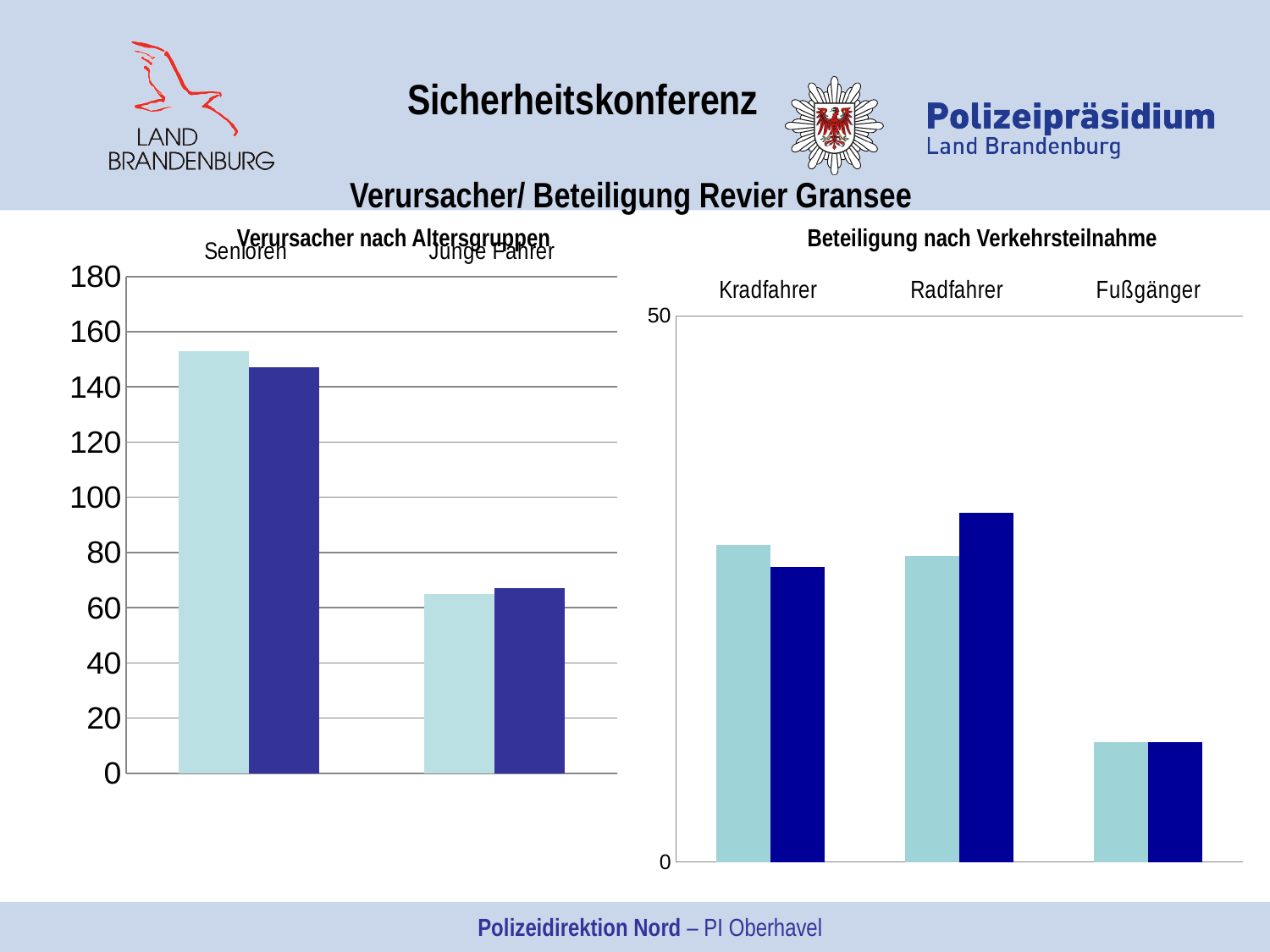
In the 'Beteiligung nach Verkehrsteilnahme' chart, which category has the lowest bars? Fußgänger In the 'Beteiligung nach Verkehrsteilnahme' chart, which category has the tallest bar? Radfahrer In the 'Verursacher nach Altersgruppen' chart, is the value of the light blue bar for Senioren greater or less than 140? greater In the 'Beteiligung nach Verkehrsteilnahme' chart, which is larger: the dark blue bar for Radfahrer or the dark blue bar for Fußgänger? Radfahrer What is the title of the chart on the right side of the slide? Beteiligung nach Verkehrsteilnahme In the 'Verursacher nach Altersgruppen' chart, do the values rise or fall from Senioren to Junge Fahrer? fall What kind of chart is the 'Verursacher nach Altersgruppen' chart on the left? bar chart In the 'Beteiligung nach Verkehrsteilnahme' chart, is the value of the dark blue bar for Kradfahrer greater or less than 50? less How many categories are shown on the x axis of the 'Beteiligung nach Verkehrsteilnahme' chart? 3 In the 'Verursacher nach Altersgruppen' chart, is the value of the light blue bar for Junge Fahrer greater or less than 80? less In the 'Verursacher nach Altersgruppen' chart, which category has the highest bars? Senioren How many categories are shown on the x axis of the 'Verursacher nach Altersgruppen' chart? 2